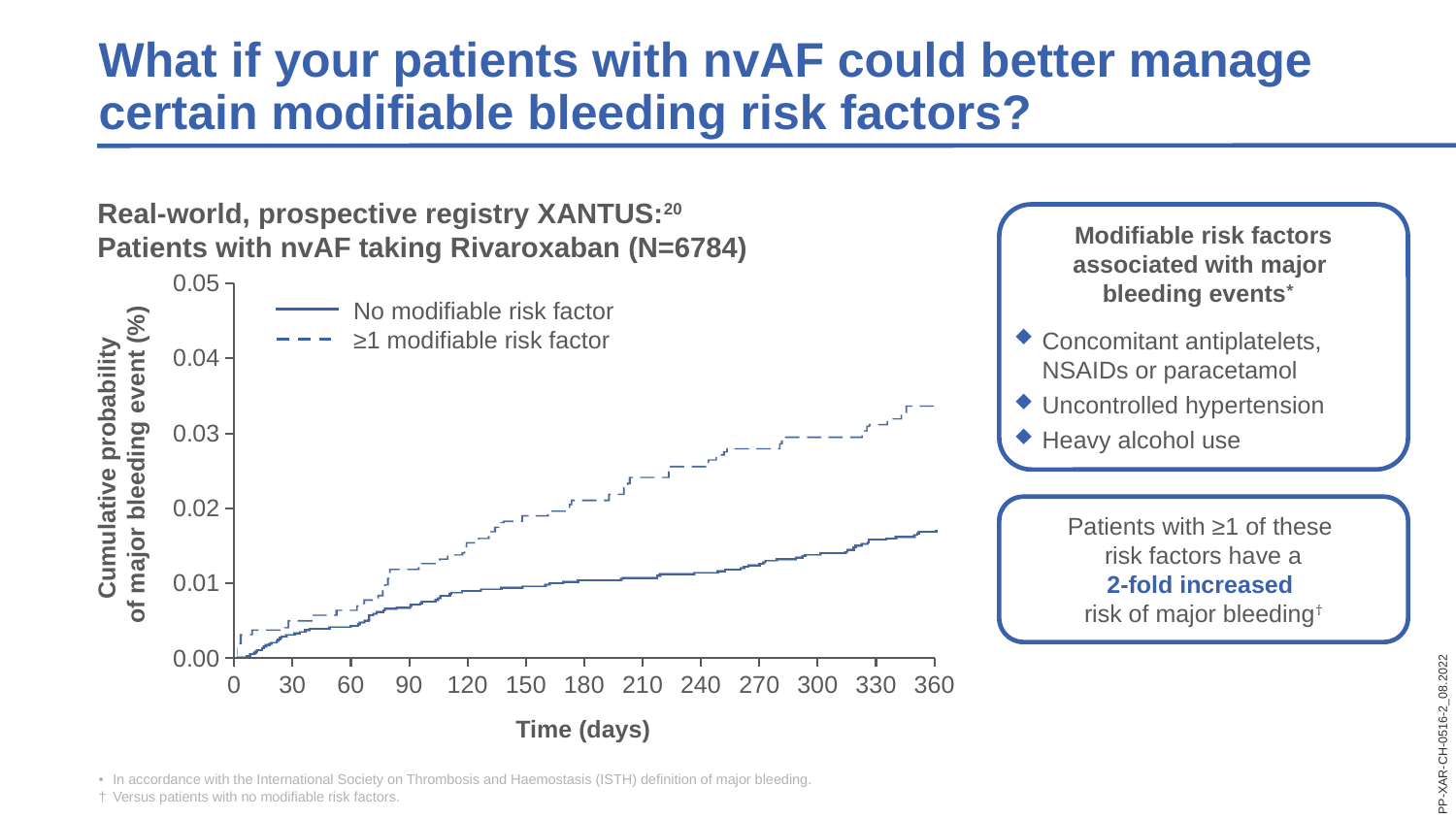
What is the highest value shown on the y axis? 0.05 At 360 days, which series has the higher cumulative probability of a major bleeding event? ≥1 modifiable risk factor Do the values of the ≥1 modifiable risk factor series rise or fall as time increases along the x axis? rise Is the value for the ≥1 modifiable risk factor series at 360 days greater or less than 0.03? greater What is the label of the x axis? Time (days) Is the value for the ≥1 modifiable risk factor series at 120 days greater or less than 0.01? greater Which series is drawn with a dashed line? ≥1 modifiable risk factor Is the value for the No modifiable risk factor series at 360 days greater or less than 0.02? less How many series does the chart's legend list? 2 What kind of chart is shown on the slide? Line chart